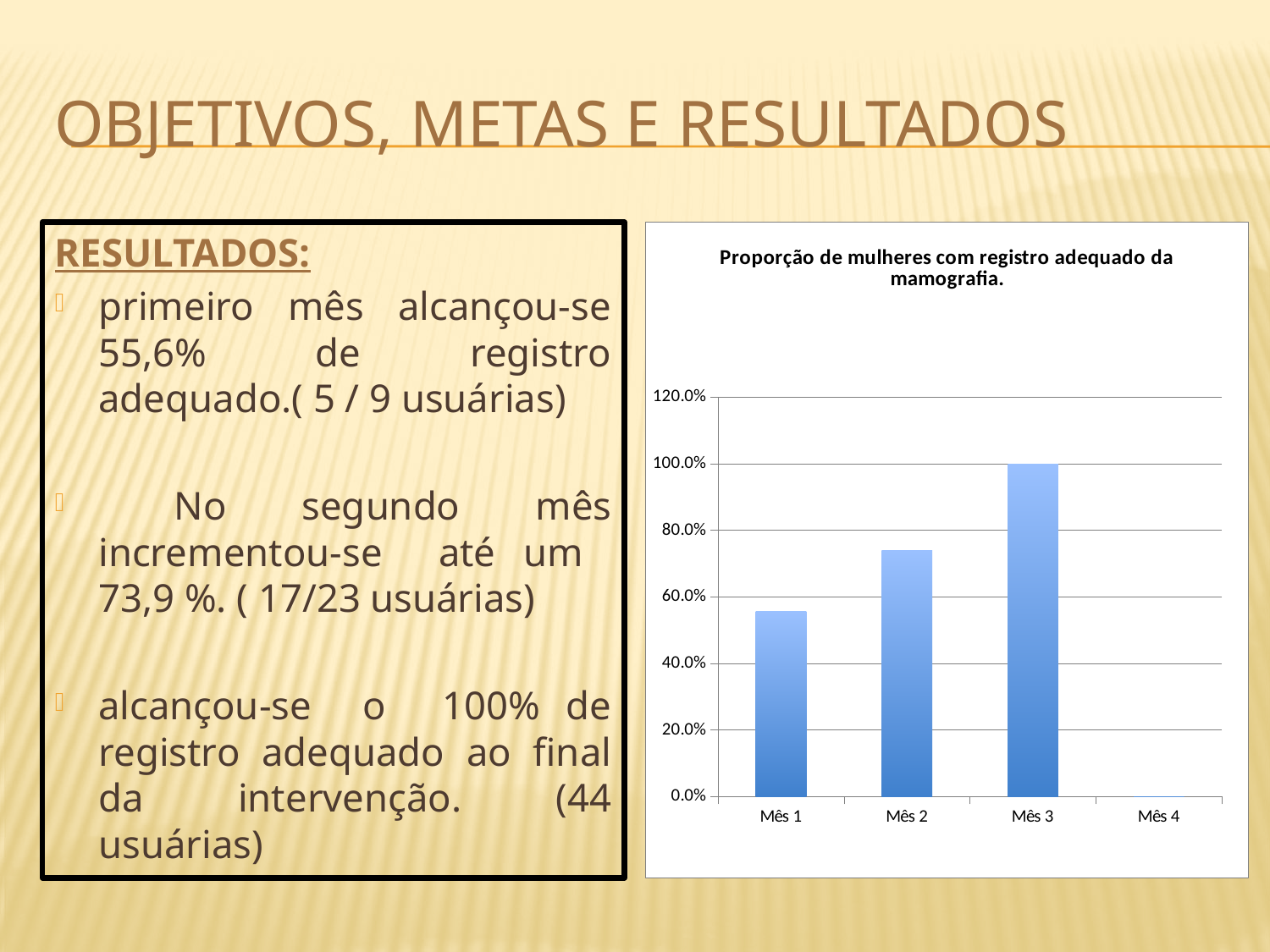
Do the bar values rise or fall from Mês 1 to Mês 3? rise Is the value for Mês 1 greater or less than 60.0%? less How many categories are shown on the x axis of the chart? 4 Which is larger, the value for Mês 1 or the value for Mês 2? Mês 2 Is the value for Mês 2 greater or less than 60.0%? greater What is the value for Mês 3 in the chart? 100.0% Which month has the highest bar in the chart? Mês 3 Is the value for Mês 2 greater or less than 80.0%? less Which month on the x axis has no bar plotted? Mês 4 What kind of chart is shown on the slide? bar chart What is the title of the chart? Proporção de mulheres com registro adequado da mamografia.